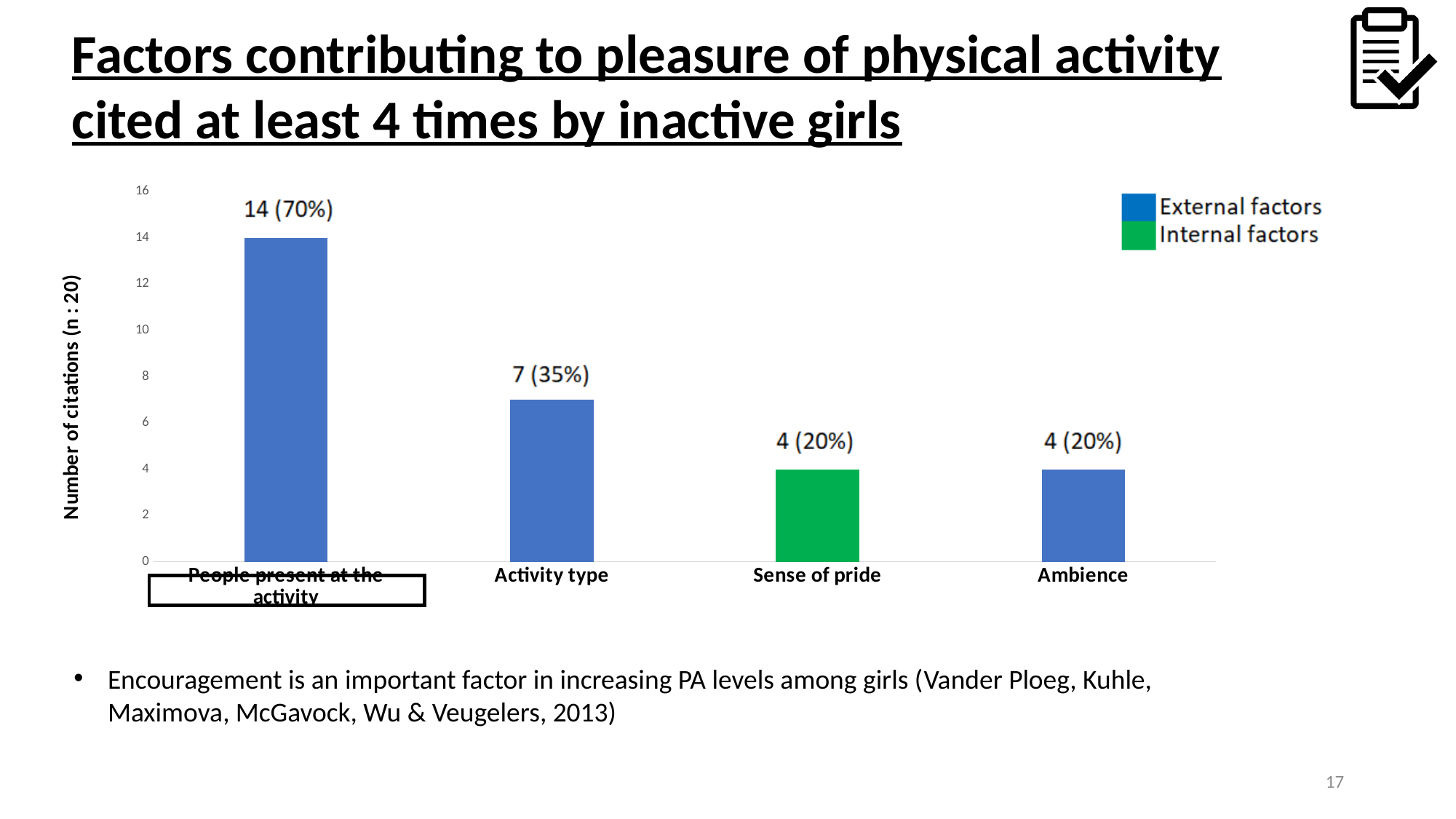
How many series does the legend list? 2 What is the data label shown for Activity type? 7 (35%) Which factor has the highest number of citations? People present at the activity What is the y-axis title of the chart? Number of citations (n : 20) Which factor is shown as an internal factor (green bar)? Sense of pride What is the difference in citations between People present at the activity and Activity type? 7 Do the values rise or fall from left to right along the x axis? Fall Which has more citations, Activity type or Ambience? Activity type What percentage is shown for People present at the activity? 70% How many citations does Sense of pride have? 4 What type of chart is shown? Bar chart How many factors (categories) are shown on the x axis? 4